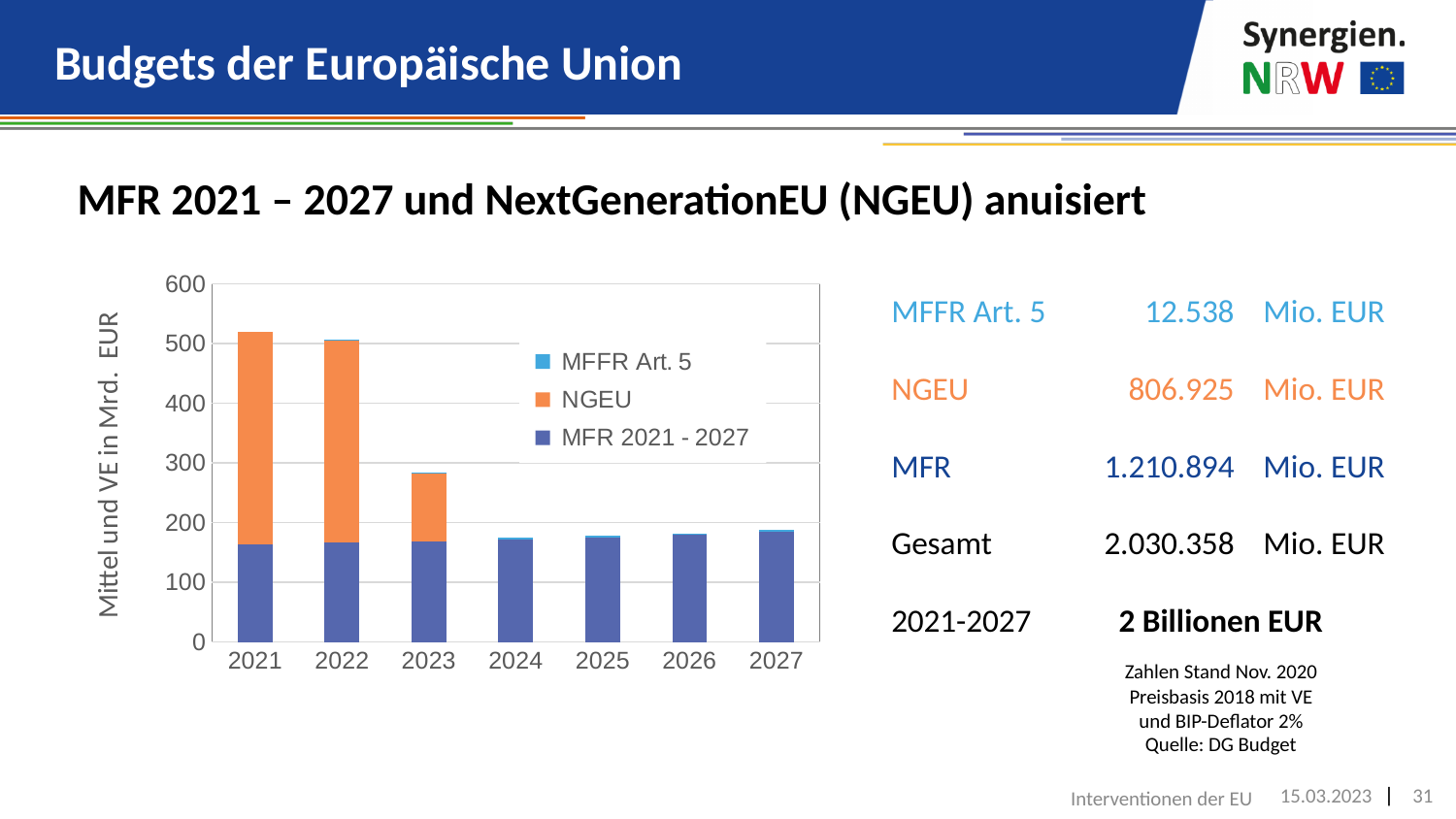
Do the total bar heights rise or fall from 2021 to 2024? fall What is the label of the y axis of the chart? Mittel und VE in Mrd. EUR What kind of chart is shown on the slide? Stacked bar chart Is the total bar for 2023 greater or less than 300? less How many years are shown on the x axis of the chart? 7 Which series is shown in orange in the chart legend? NGEU Which year has the highest total bar in the chart? 2021 Is the total bar for 2021 greater or less than 500? greater How many series does the chart legend list? 3 Which year has the larger total bar, 2021 or 2023? 2021 Is the MFR 2021 - 2027 segment for 2021 greater or less than 100? greater